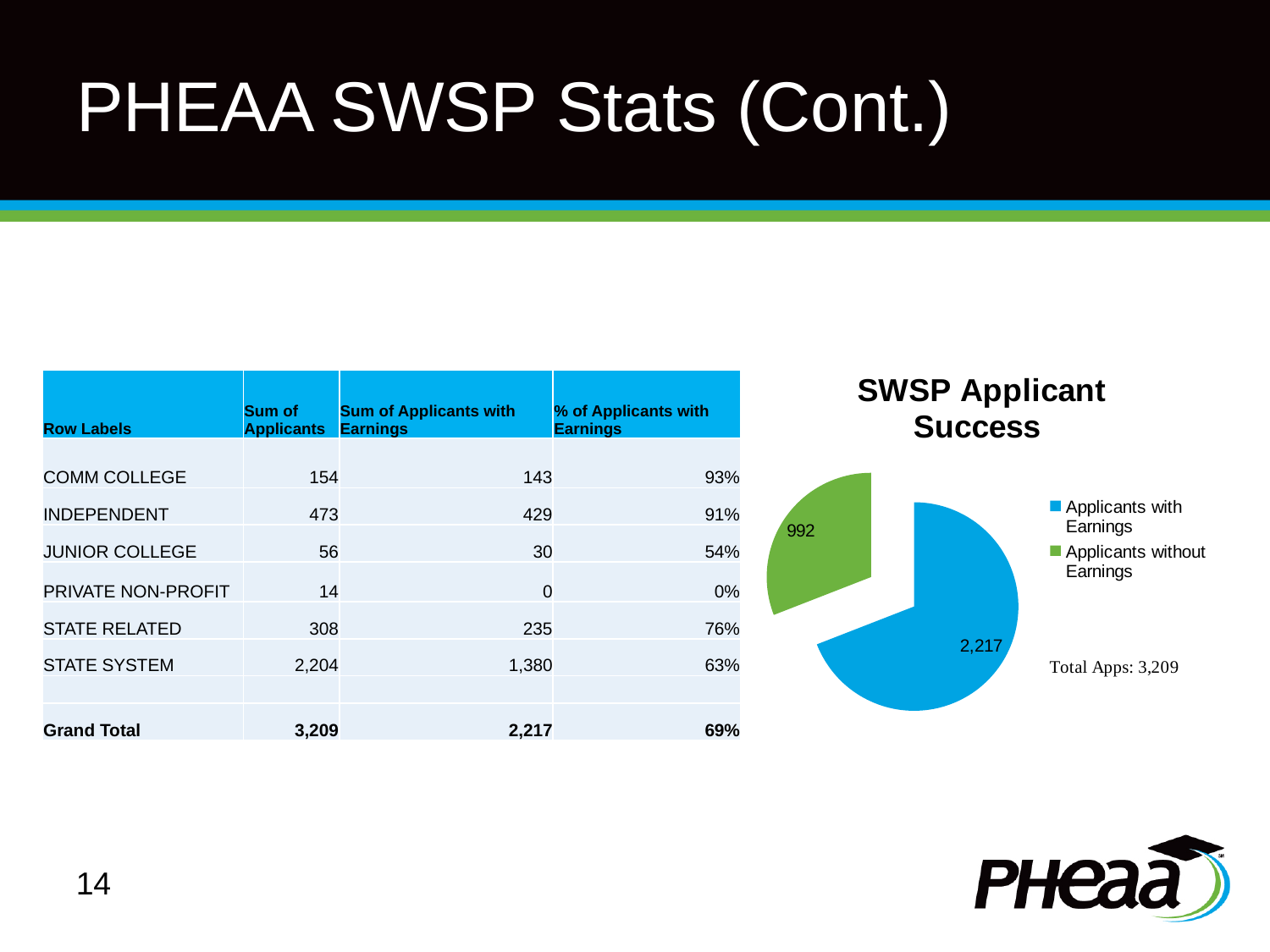
In the SWSP Applicant Success pie chart, what is the value for Applicants without Earnings? 992 Which slice of the SWSP Applicant Success pie chart is the smallest? Applicants without Earnings In the SWSP Applicant Success pie chart, which is larger: Applicants with Earnings or Applicants without Earnings? Applicants with Earnings In the SWSP Applicant Success pie chart, what is the difference between Applicants with Earnings and Applicants without Earnings? 1,225 What kind of chart is shown under the title "SWSP Applicant Success"? pie chart Which slice of the SWSP Applicant Success pie chart is the largest? Applicants with Earnings In the SWSP Applicant Success pie chart, what is the value for Applicants with Earnings? 2,217 What colour is the Applicants without Earnings slice in the SWSP Applicant Success pie chart? green How many entries does the legend of the SWSP Applicant Success pie chart list? 2 What is the total of the two slices in the SWSP Applicant Success pie chart? 3,209 How many slices does the SWSP Applicant Success pie chart have? 2 What share of the SWSP Applicant Success pie chart is Applicants with Earnings? 69%